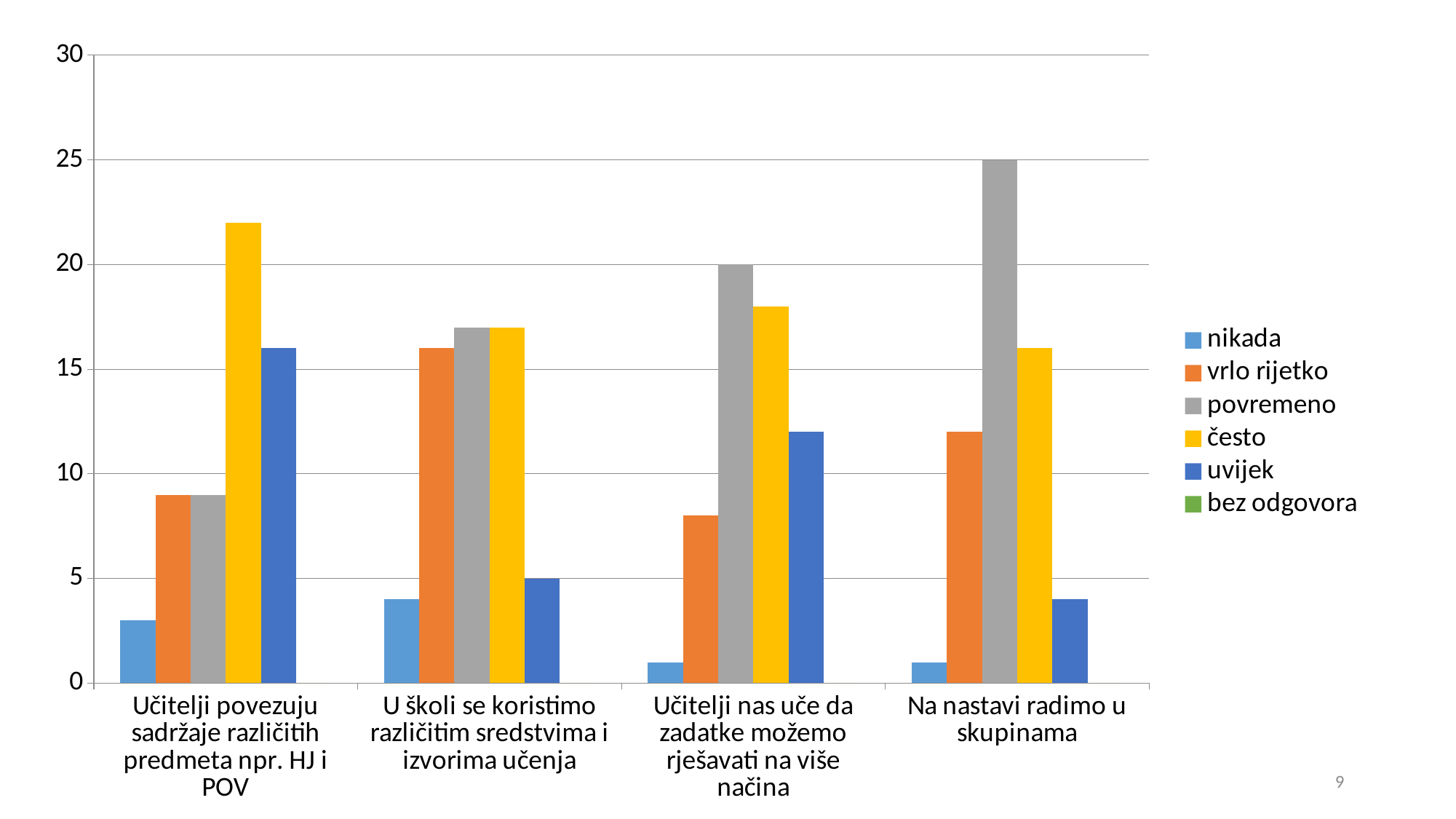
What is the value of "povremeno" for "Učitelji nas uče da zadatke možemo rješavati na više načina"? 20 Which series has the highest value for "Učitelji povezuju sadržaje različitih predmeta npr. HJ i POV"? često How many series does the legend list? 6 How many categories are shown on the x axis? 4 Which legend entry is shown in green? bez odgovora What is the value of "uvijek" for "U školi se koristimo različitim sredstvima i izvorima učenja"? 5 Which is larger: "uvijek" for "Učitelji povezuju sadržaje različitih predmeta npr. HJ i POV" or "uvijek" for "Na nastavi radimo u skupinama"? Učitelji povezuju sadržaje različitih predmeta npr. HJ i POV What is the value of "povremeno" for "Na nastavi radimo u skupinama"? 25 Is the value of "često" for "Učitelji povezuju sadržaje različitih predmeta npr. HJ i POV" greater or less than 20? greater What type of chart is shown on the slide? bar chart Is the value of "vrlo rijetko" for "Učitelji nas uče da zadatke možemo rješavati na više načina" greater or less than 10? less